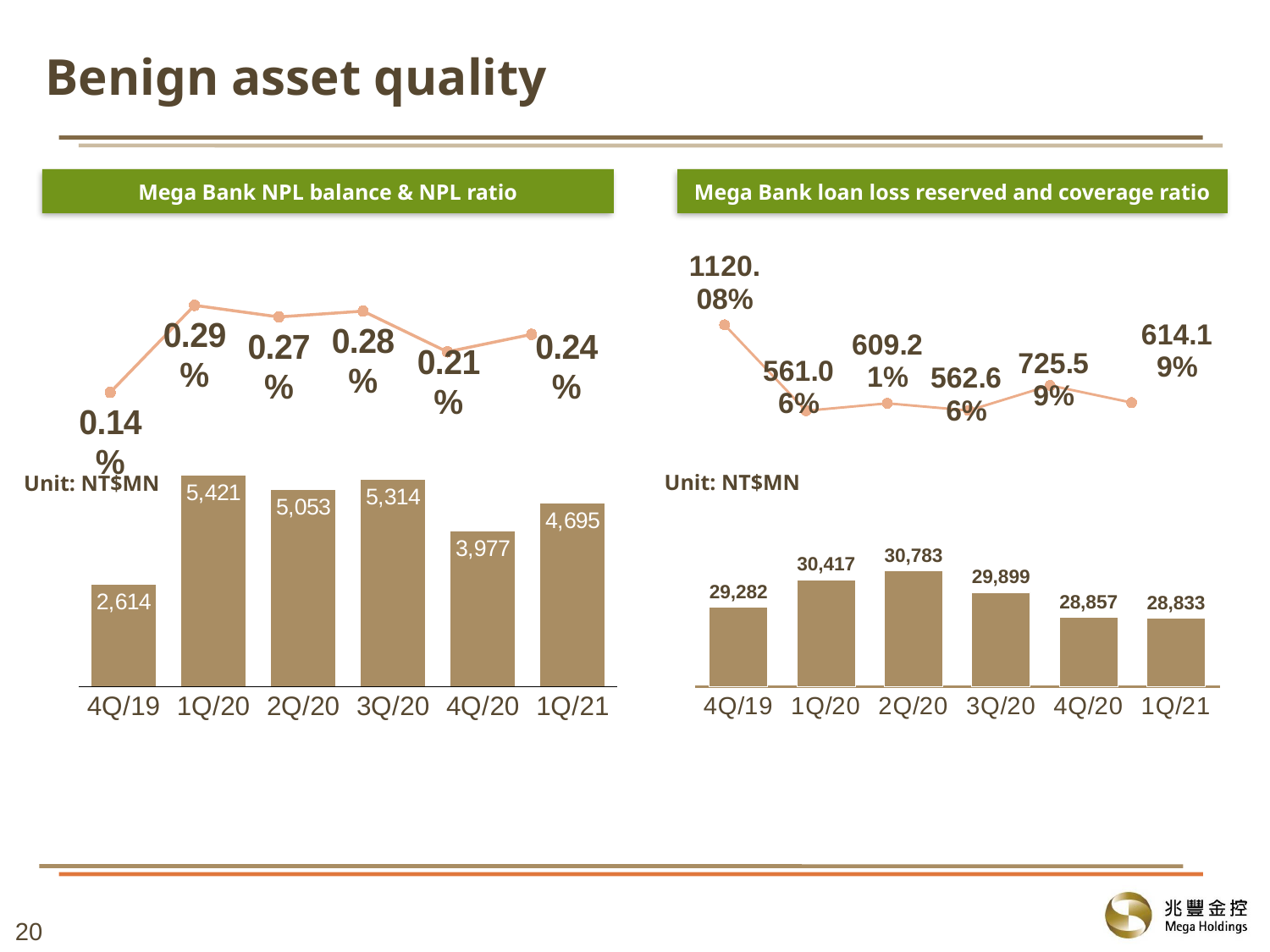
In the 'Mega Bank loan loss reserved and coverage ratio' chart, what is the loan loss reserve for 2Q/20? 30,783 In the 'Mega Bank NPL balance & NPL ratio' chart, which quarter has the highest NPL balance? 1Q/20 In the 'Mega Bank NPL balance & NPL ratio' chart, what is the difference between the NPL balance in 1Q/20 and 4Q/19? 2,807 In the 'Mega Bank loan loss reserved and coverage ratio' chart, is the loan loss reserve larger in 1Q/20 or 3Q/20? 1Q/20 In the 'Mega Bank NPL balance & NPL ratio' chart, what is the NPL ratio for 4Q/19? 0.14% In the 'Mega Bank NPL balance & NPL ratio' chart, which quarter has the lowest NPL ratio? 4Q/19 In the 'Mega Bank loan loss reserved and coverage ratio' chart, which quarter has the lowest loan loss reserve? 1Q/21 In the 'Mega Bank NPL balance & NPL ratio' chart, how many quarters are shown on the x axis? 6 In the 'Mega Bank loan loss reserved and coverage ratio' chart, which quarter has the highest coverage ratio? 4Q/19 What unit is stated for the bar values in both charts? NT$MN In the 'Mega Bank NPL balance & NPL ratio' chart, what is the NPL balance for 1Q/21? 4,695 In the 'Mega Bank loan loss reserved and coverage ratio' chart, what is the coverage ratio for 4Q/20? 725.59%